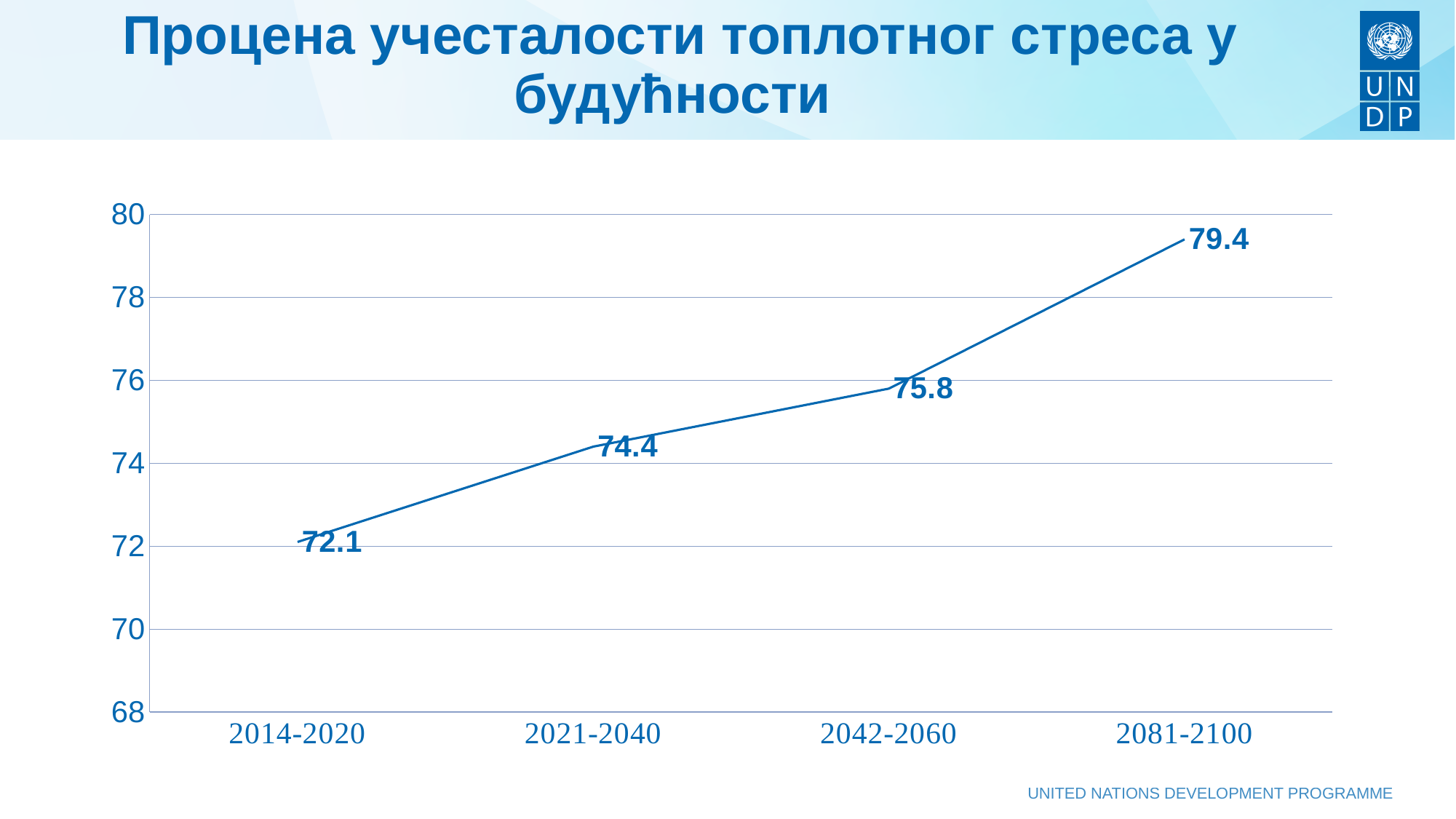
Which period has the highest value? 2081-2100 What is the value for 2021-2040? 74.4 What is the difference between the values for 2042-2060 and 2021-2040? 1.4 What is the value for 2081-2100? 79.4 How many periods are plotted on the x axis? 4 What is the value for 2042-2060? 75.8 Do the values rise or fall from 2014-2020 to 2081-2100? rise Which is larger, the value for 2021-2040 or the value for 2042-2060? 2042-2060 What is the value for 2014-2020? 72.1 What is the difference between the values for 2081-2100 and 2014-2020? 7.3 What kind of chart is shown on the slide? line chart Which period has the lowest value? 2014-2020